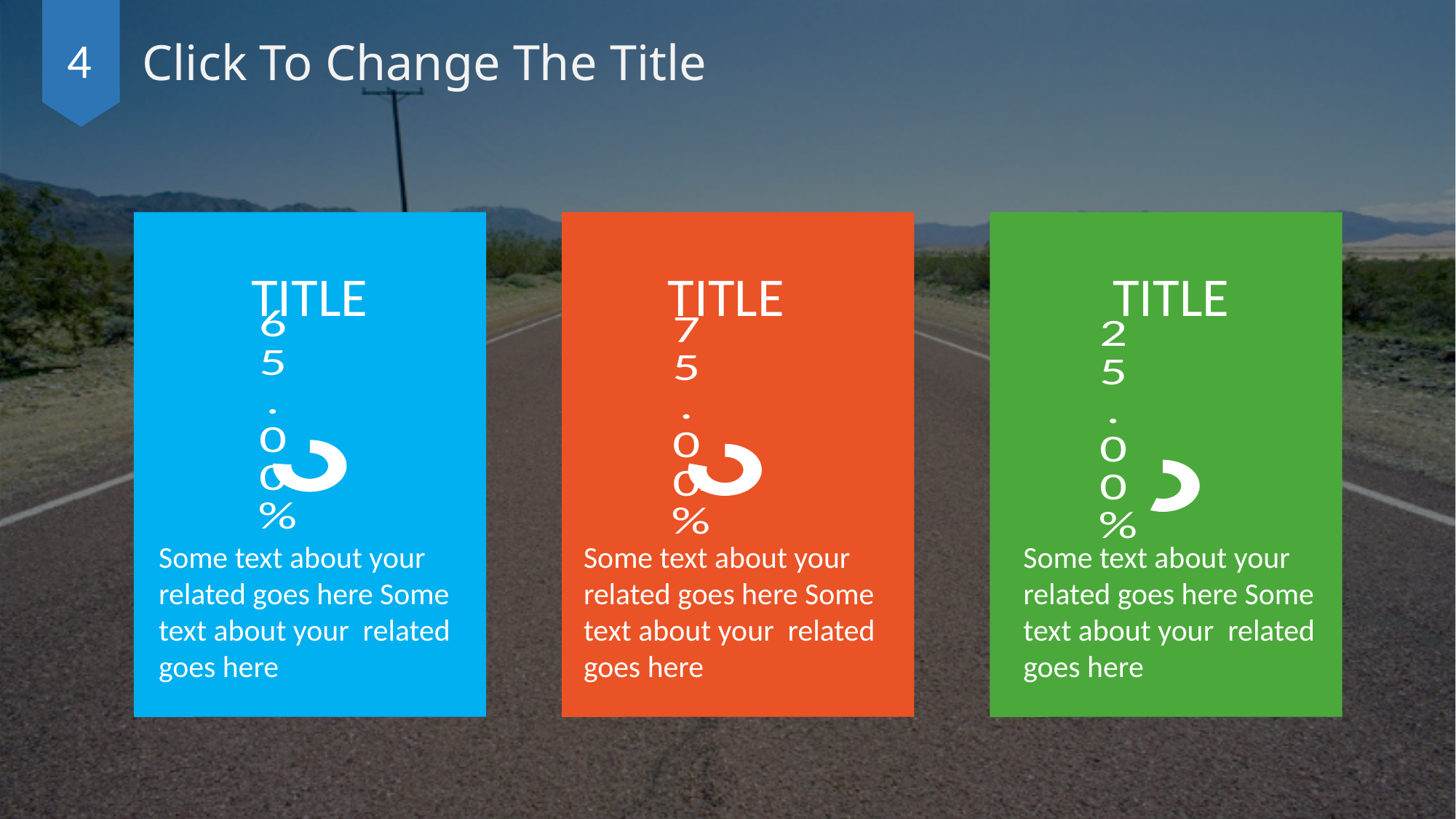
What value is shown on the chart in the right (green) panel? 25.00% Which panel's chart shows the highest percentage? The middle (orange) panel What is the heading printed above each chart? TITLE What kind of chart is shown in each panel? Doughnut chart How many charts are shown on the slide? 3 What is the difference between the percentage in the middle (orange) panel and the percentage in the left (blue) panel? 10.00% Is the value shown in the right (green) panel greater or less than 50%? less What is the difference between the percentage in the middle (orange) panel and the percentage in the right (green) panel? 50.00% Which panel's chart shows the lowest percentage? The right (green) panel What value is shown on the chart in the middle (orange) panel? 75.00% What value is shown on the chart in the left (blue) panel? 65.00% Which is larger, the percentage in the left (blue) panel or the percentage in the right (green) panel? The left (blue) panel